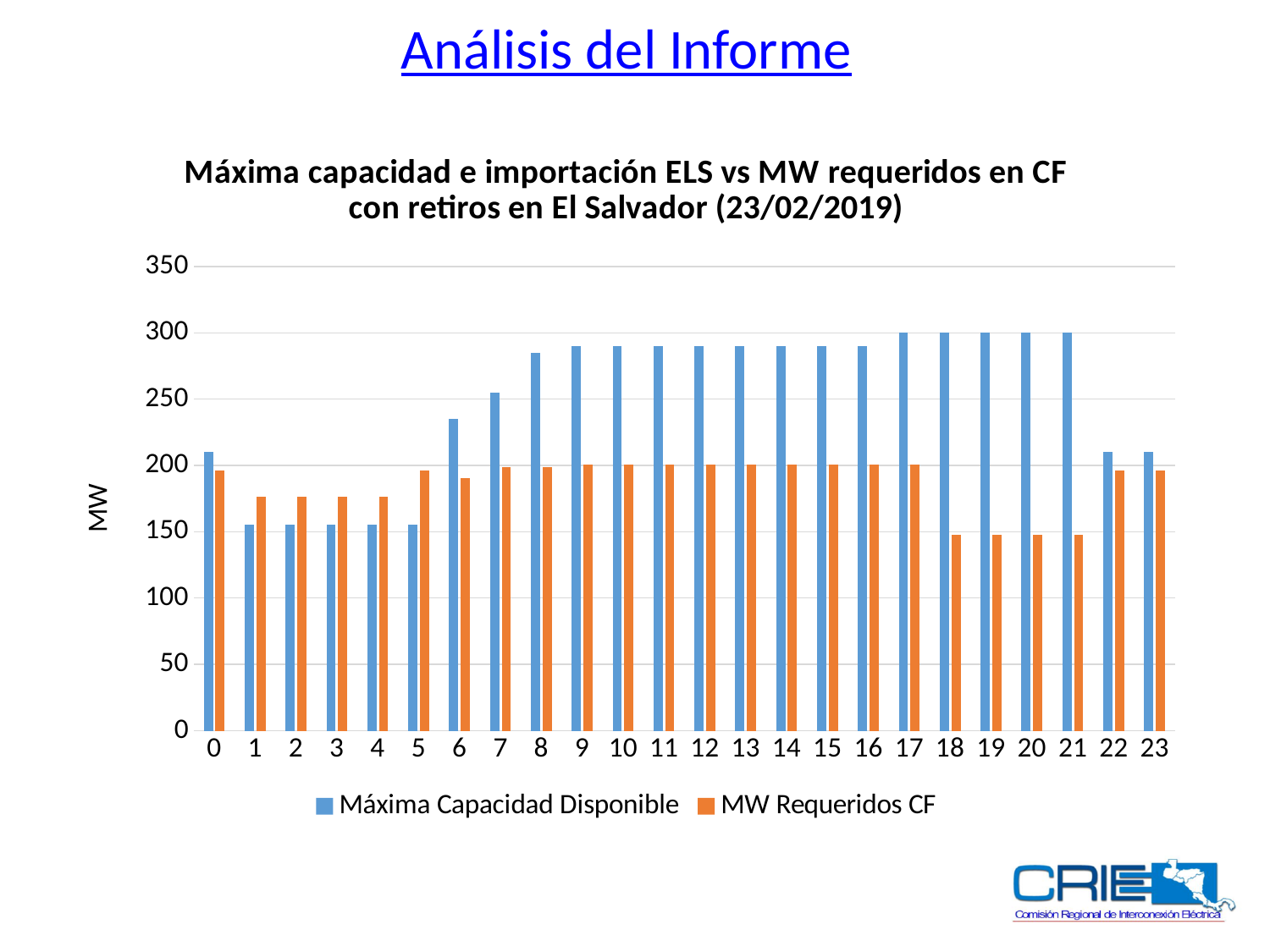
At hour 12, which series has the larger value? Máxima Capacidad Disponible What is the value of Máxima Capacidad Disponible at hour 19? 300 Is the value of Máxima Capacidad Disponible at hour 10 greater or less than 250? greater Is the value of Máxima Capacidad Disponible at hour 1 greater or less than 200? less How many hour categories are shown on the x axis? 24 Is the value of MW Requeridos CF at hour 2 greater or less than 150? greater At hour 3, which series has the larger value? MW Requeridos CF Does Máxima Capacidad Disponible rise or fall from hour 5 to hour 8? rise How many series does the legend list? 2 What is the label on the vertical axis? MW What kind of chart is shown on the slide? bar chart